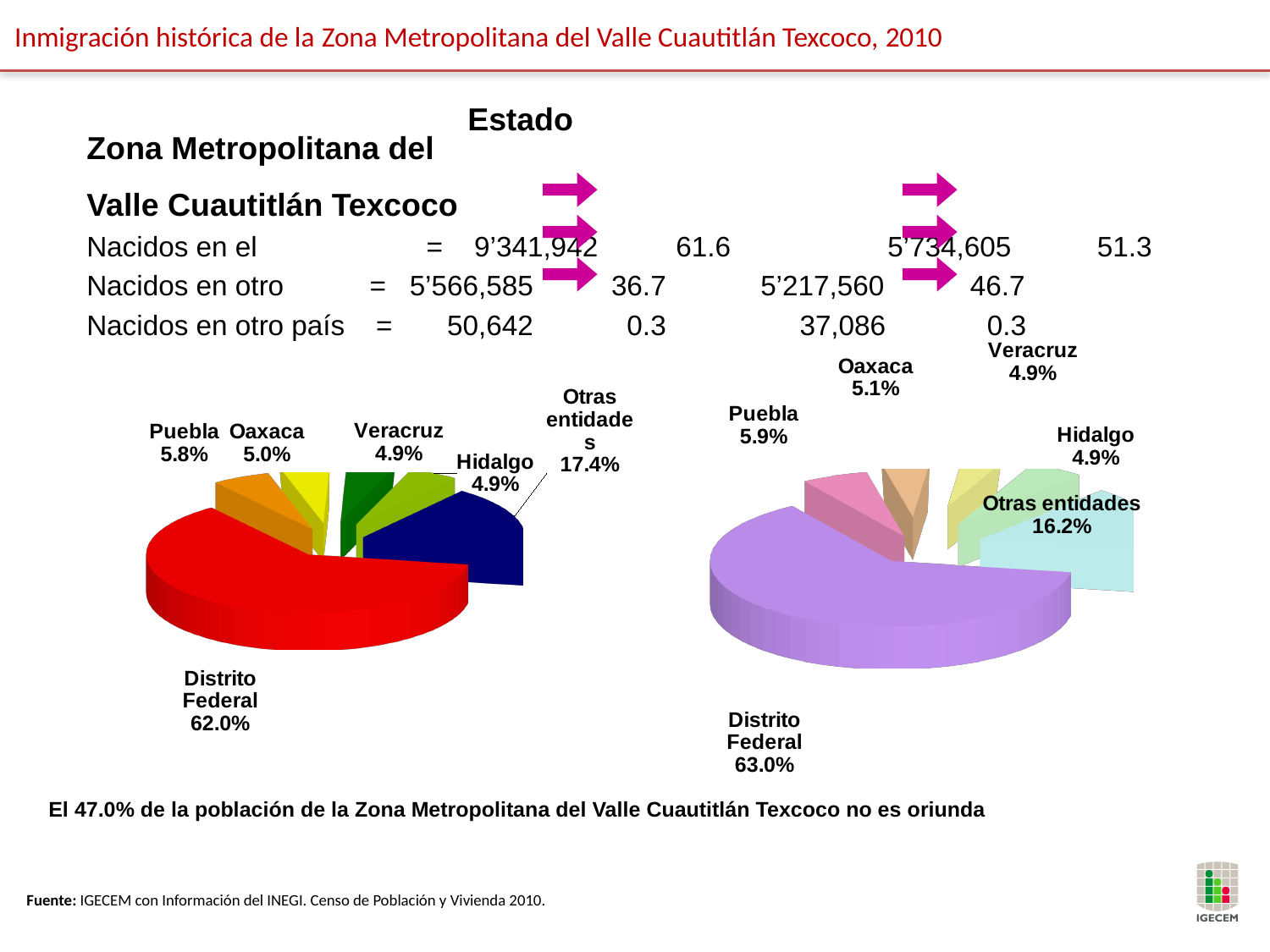
In the left pie chart, what share does Distrito Federal have? 62.0% In the left pie chart, which category has the largest slice? Distrito Federal In the left pie chart, what is the difference between the Distrito Federal share and the Otras entidades share? 44.6% In the right pie chart, what is the value for Puebla? 5.9% In the left pie chart, what is the value for Otras entidades? 17.4% What kind of chart is the left chart on the slide? pie chart In the right pie chart, which category has the largest slice? Distrito Federal In the right pie chart, what is the value for Otras entidades? 16.2% How many slices does the left pie chart have? 6 What colour is the Distrito Federal slice in the left pie chart? red In the left pie chart, which is larger, the Puebla slice or the Oaxaca slice? Puebla In the right pie chart, what share does Distrito Federal have? 63.0%